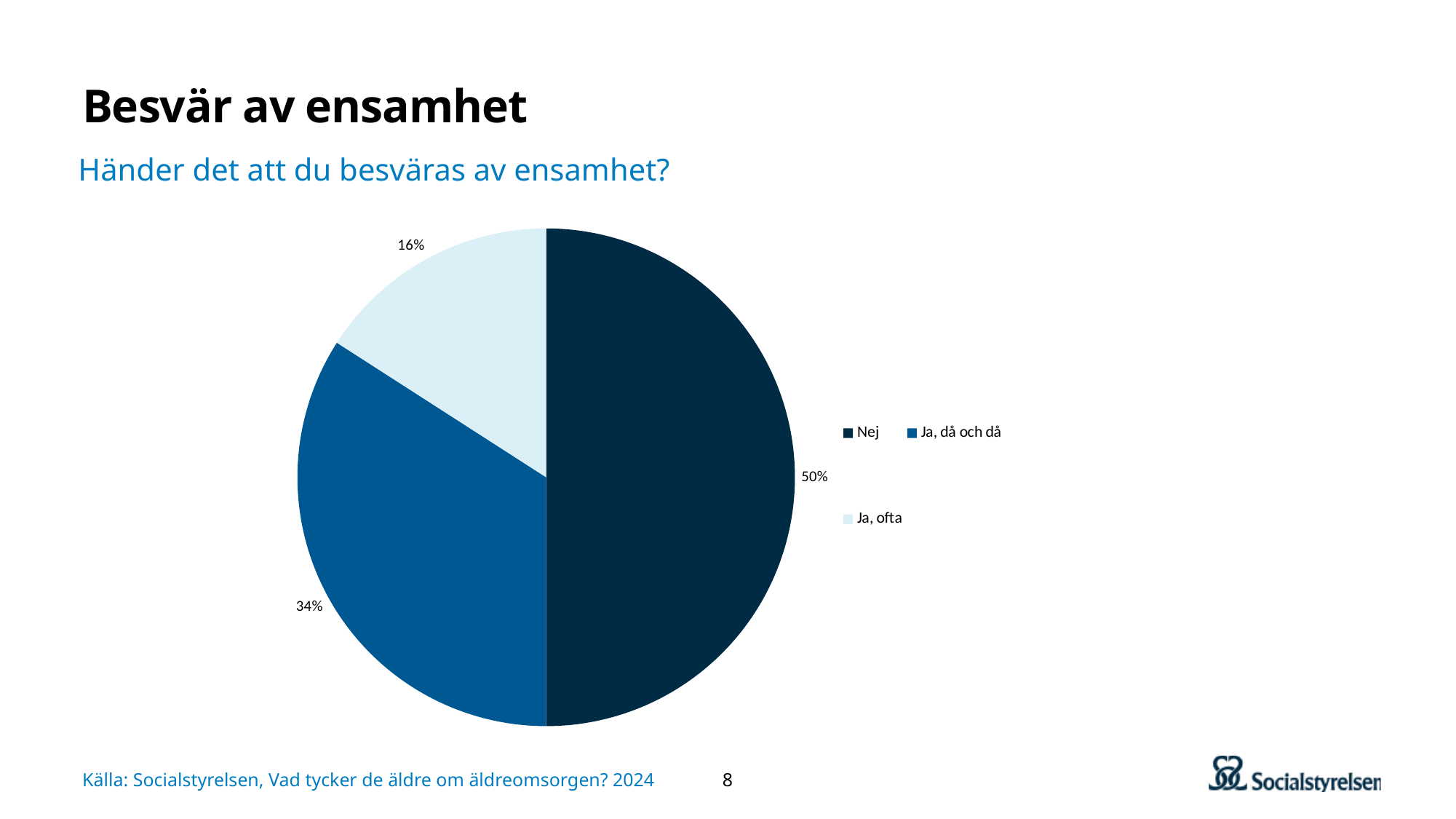
What percentage of the pie chart is the 'Nej' slice? 50% Which is larger, the 'Ja, då och då' slice or the 'Ja, ofta' slice? Ja, då och då What is the difference in percentage points between the 'Ja, då och då' slice and the 'Ja, ofta' slice? 18 What percentage of the pie chart is the 'Ja, ofta' slice? 16% What is the difference in percentage points between the 'Nej' slice and the 'Ja, då och då' slice? 16 Which category has the largest share of the pie chart? Nej What kind of chart is shown on the slide? Pie chart How many entries does the legend list? 3 How many slices does the pie chart have? 3 What question is shown as the chart's subtitle? Händer det att du besväras av ensamhet? Which category has the smallest share of the pie chart? Ja, ofta What percentage of the pie chart is the 'Ja, då och då' slice? 34%